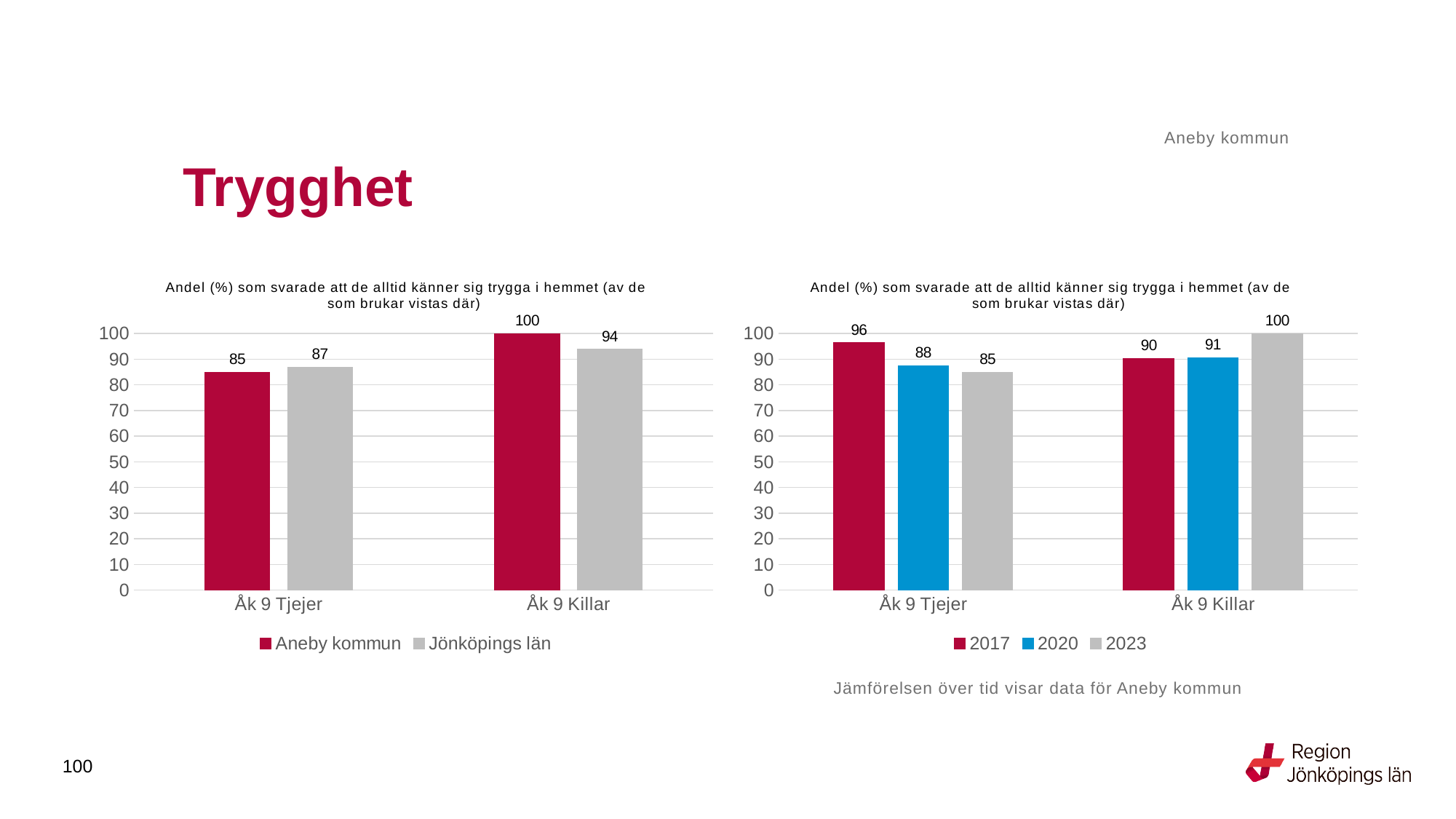
In the right chart, which year has the lowest value for Åk 9 Tjejer? 2023 In the left chart, what is the value for Jönköpings län for Åk 9 Killar? 94 How many series does the legend of the left chart list? 2 In the right chart, what is the value for 2023 for Åk 9 Killar? 100 In the right chart, do the values for Åk 9 Killar rise or fall from 2017 to 2023? rise In the right chart, what is the difference between the 2017 and 2023 values for Åk 9 Tjejer? 11 In the right chart, what is the value for 2017 for Åk 9 Tjejer? 96 In the left chart, what is the difference between Aneby kommun and Jönköpings län for Åk 9 Killar? 6 In the left chart, which is larger for Åk 9 Tjejer: Aneby kommun or Jönköpings län? Jönköpings län In the left chart, what is the value for Aneby kommun for Åk 9 Tjejer? 85 How many series does the legend of the right chart list? 3 What kind of chart is the right chart? bar chart